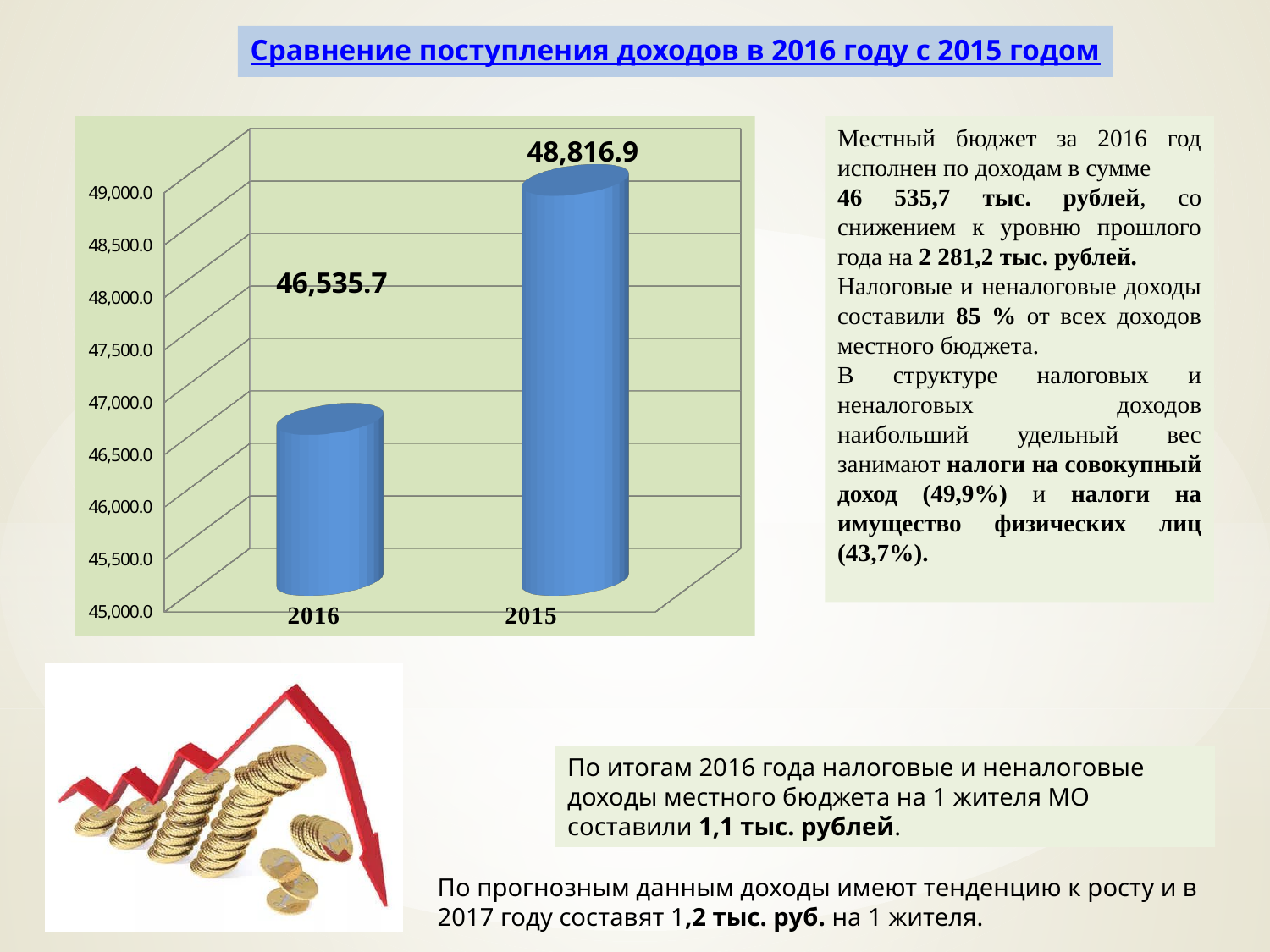
Which year has the lower value on the chart? 2016 What is the value shown for 2016 on the chart? 46,535.7 What kind of chart is shown on the slide? bar chart Is the value for 2016 greater or less than 46,000.0? greater Is the value for 2015 greater or less than 48,500.0? greater What is the difference between the 2015 value and the 2016 value on the chart? 2,281.2 What is the value shown for 2015 on the chart? 48,816.9 How many categories are plotted on the chart? 2 Is the value for 2016 larger or smaller than the value for 2015? smaller Do the values rise or fall from left to right along the x axis of the chart? rise What is the lowest value shown on the chart's vertical axis? 45,000.0 Which year has the higher value on the chart? 2015